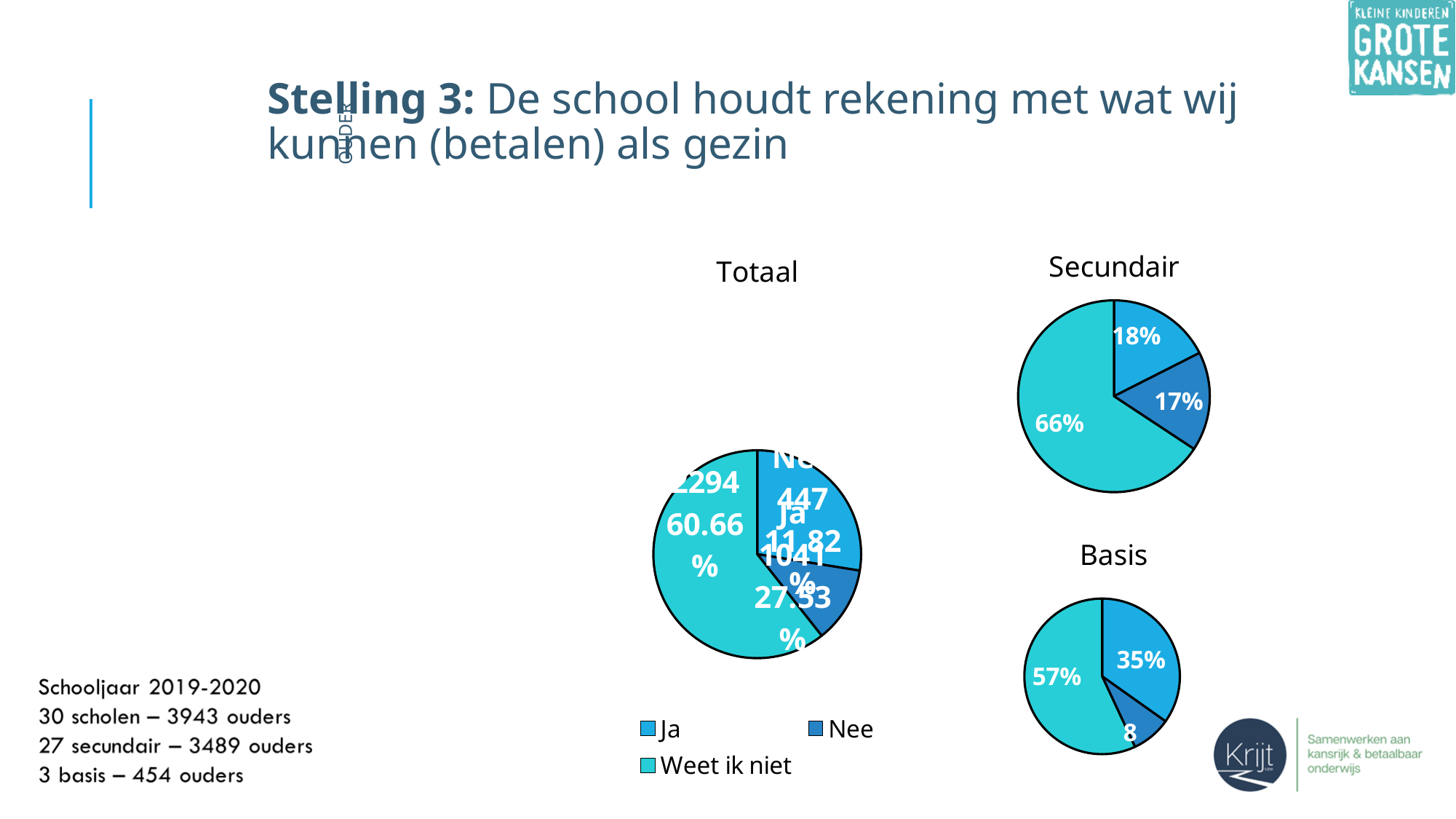
In the Totaal pie chart, what percentage is shown for the 'Weet ik niet' slice? 60.66% In the Secundair pie chart, what percentage is shown for the 'Weet ik niet' slice? 66% In the Secundair pie chart, which is larger: 'Weet ik niet' or 'Ja'? Weet ik niet In the Basis pie chart, what percentage is shown for 'Weet ik niet'? 57% In the Secundair pie chart, what percentage is shown for 'Ja'? 18% In the Basis pie chart, which category has the smallest slice? Nee How many categories does the legend list for the pie charts? 3 In the Basis pie chart, what percentage is shown for 'Ja'? 35% What type of chart is used for Totaal, Secundair and Basis? Pie chart In the Secundair pie chart, what percentage is shown for 'Nee'? 17% In the Secundair pie chart, which category has the largest slice? Weet ik niet In the Basis pie chart, how many percentage points larger is 'Weet ik niet' than 'Ja'? 22 percentage points